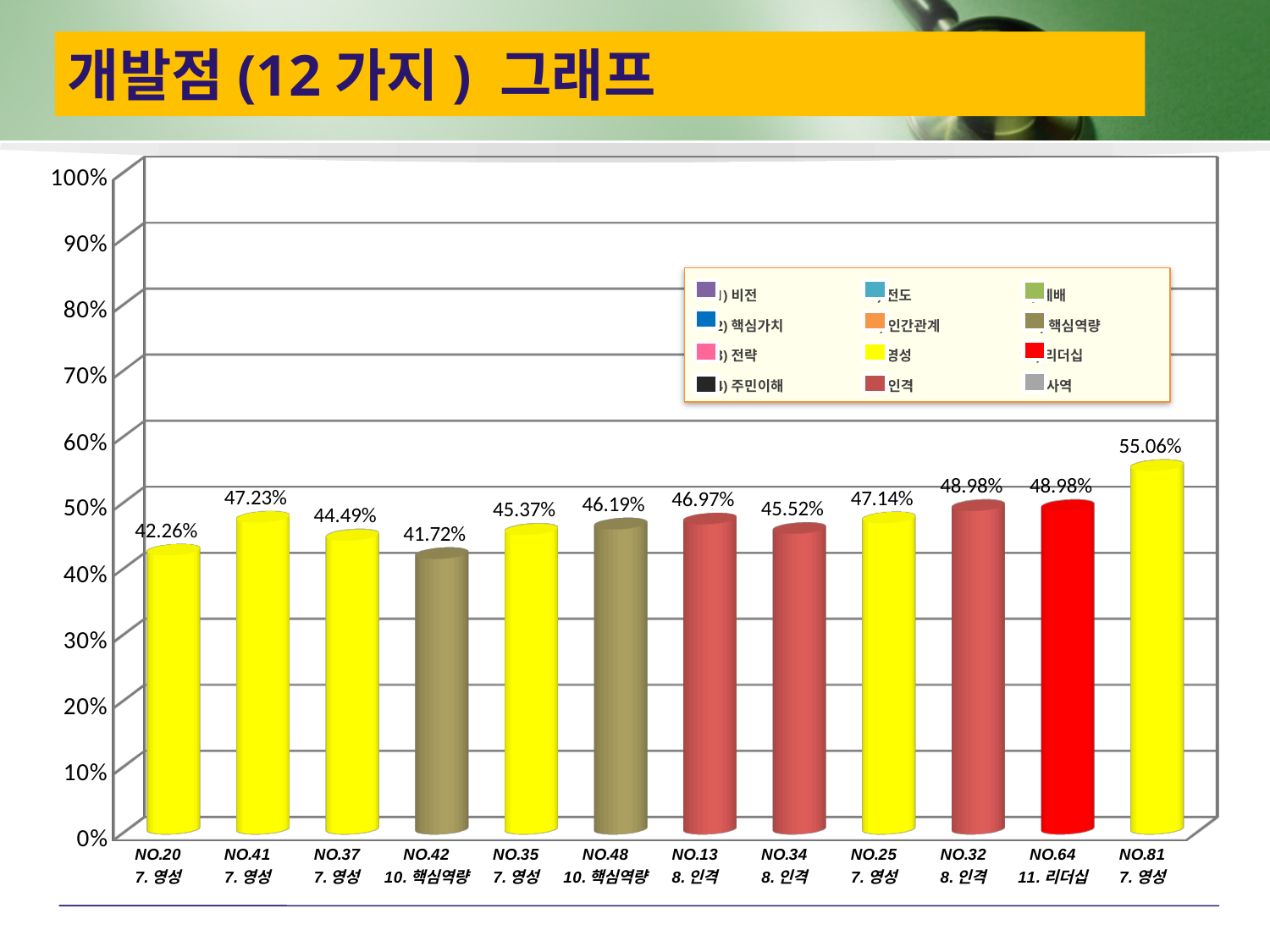
What colour is the bar for NO.64 (11. 리더십)? Red Is the value for NO.81 greater or less than 50%? greater What is the value for NO.81 (7. 영성)? 55.06% What type of chart is shown on the slide? Bar chart Which category has the lowest value? NO.42 (10. 핵심역량) What is the value for NO.13 (8. 인격)? 46.97% How many entries does the legend list? 12 Which category has the highest value? NO.81 (7. 영성) What is the value for NO.42 (10. 핵심역량)? 41.72% How many bars are plotted in the chart? 12 Which is larger, the value for NO.41 or the value for NO.37? NO.41 What is the difference between the values for NO.81 and NO.42? 13.34%